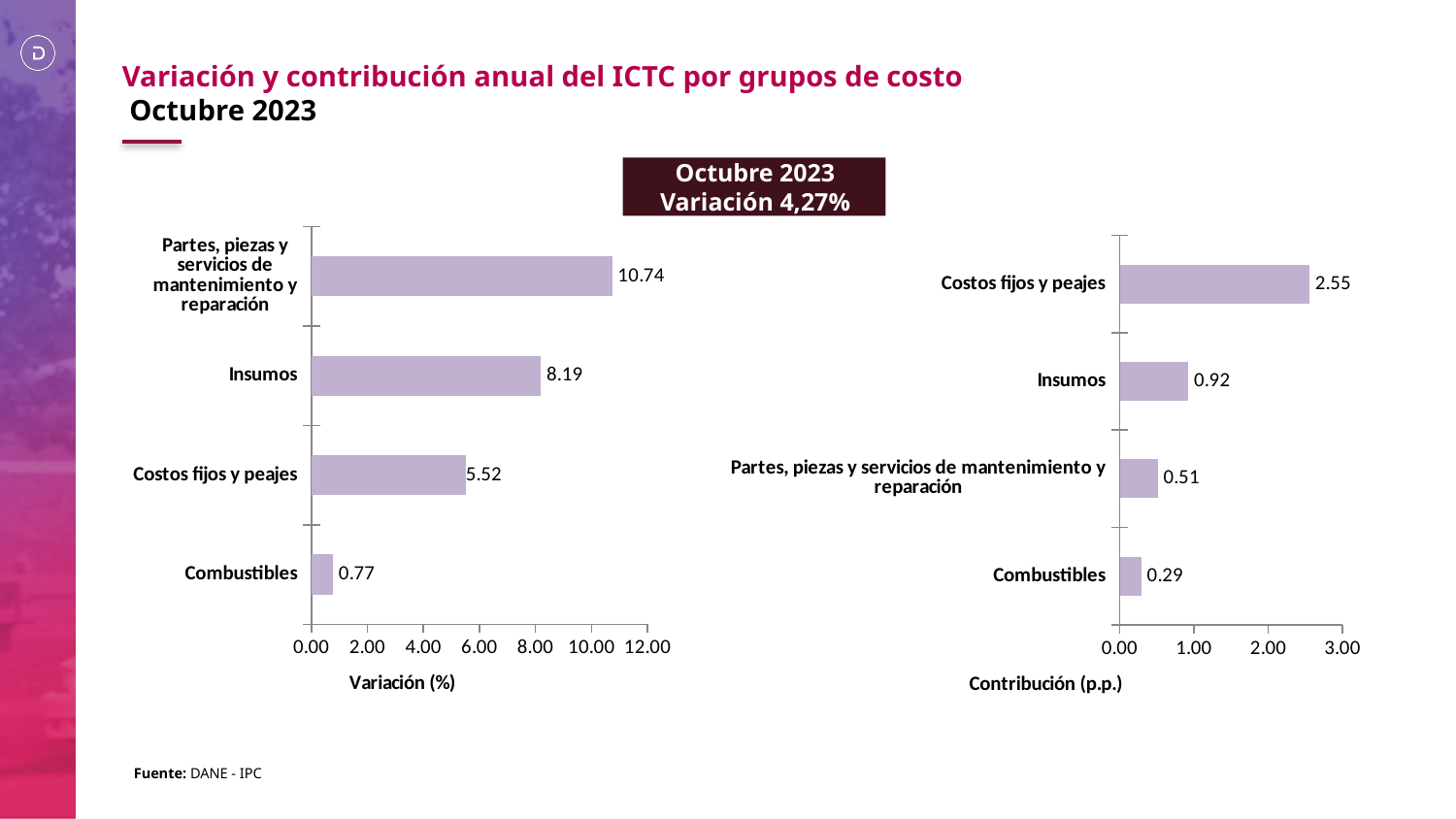
In the left chart (Variación (%)), what is the value for Combustibles? 0.77 In the left chart (Variación (%)), which is larger: the value for Costos fijos y peajes or the value for Combustibles? Costos fijos y peajes In the left chart (Variación (%)), which category has the highest value? Partes, piezas y servicios de mantenimiento y reparación What total variation is shown in the box above the charts for Octubre 2023? 4,27% In the right chart (Contribución (p.p.)), what is the difference between the values for Costos fijos y peajes and Insumos? 1.63 In the right chart (Contribución (p.p.)), which category has the lowest value? Combustibles In the left chart (Variación (%)), what is the value for Insumos? 8.19 In the right chart (Contribución (p.p.)), is the value for Insumos greater or less than 1.00? less In the right chart (Contribución (p.p.)), what is the value for Costos fijos y peajes? 2.55 What kind of chart is the right chart (Contribución (p.p.))? bar chart In the left chart (Variación (%)), what is the difference between the values for Insumos and Costos fijos y peajes? 2.67 How many categories are shown in the left chart (Variación (%))? 4